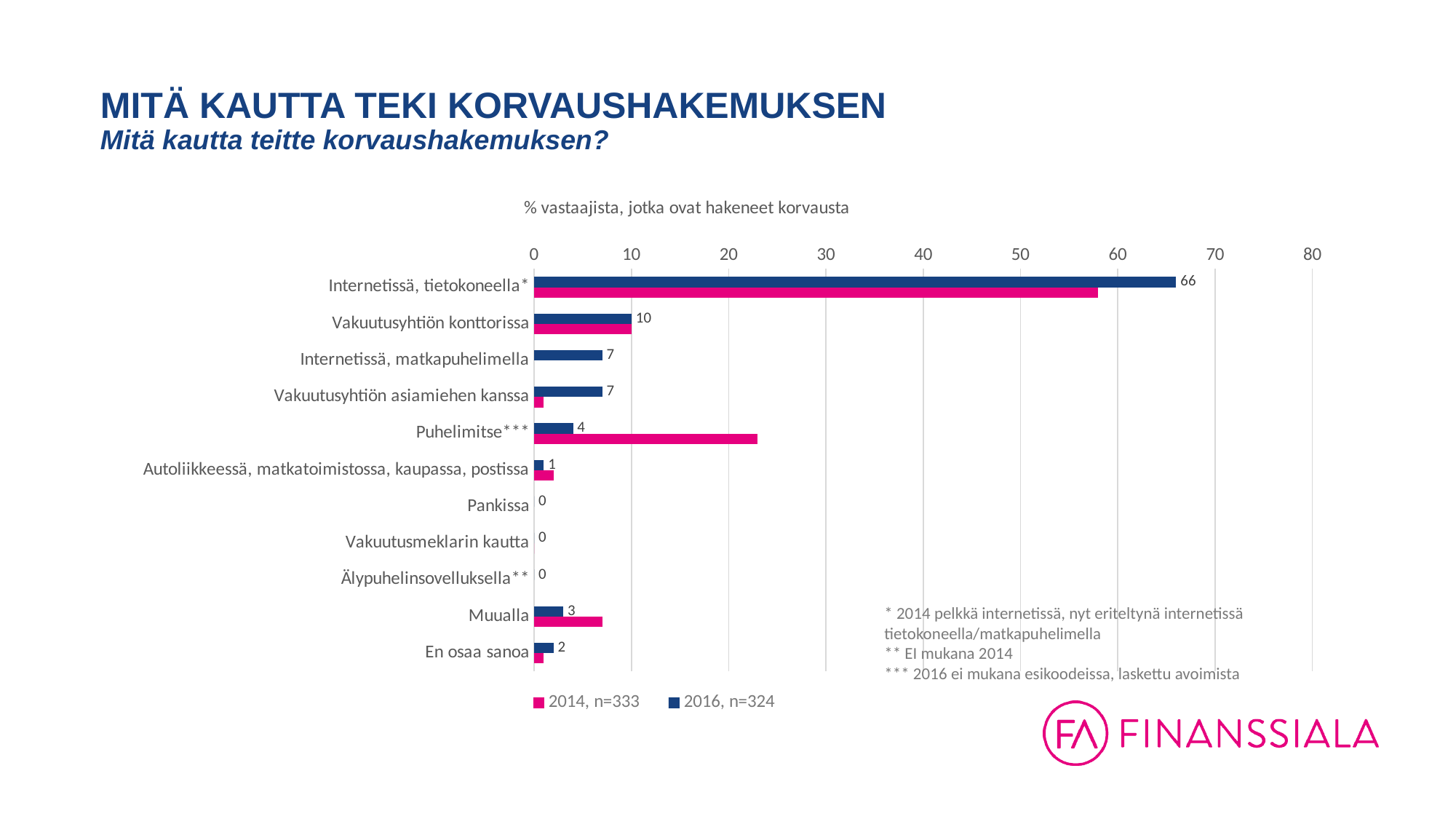
How many categories are shown on the chart? 11 What kind of chart is shown on the slide? Bar chart For "Puhelimitse***", which series has the larger value: 2014 or 2016? 2014 Is the 2014 value for "Puhelimitse***" greater or less than 20? greater What is the 2016 value for "En osaa sanoa"? 2 What is the 2016 value for "Internetissä, tietokoneella*"? 66 Which category has the highest 2016 value? Internetissä, tietokoneella* What is the difference between the 2016 values for "Internetissä, tietokoneella*" and "Vakuutusyhtiön konttorissa"? 56 What is the 2016 value for "Vakuutusyhtiön konttorissa"? 10 How many series does the legend list? 2 Is the 2014 value for "Internetissä, tietokoneella*" greater or less than 50? greater For 2016, which is larger: "Puhelimitse***" or "Muualla"? Puhelimitse***